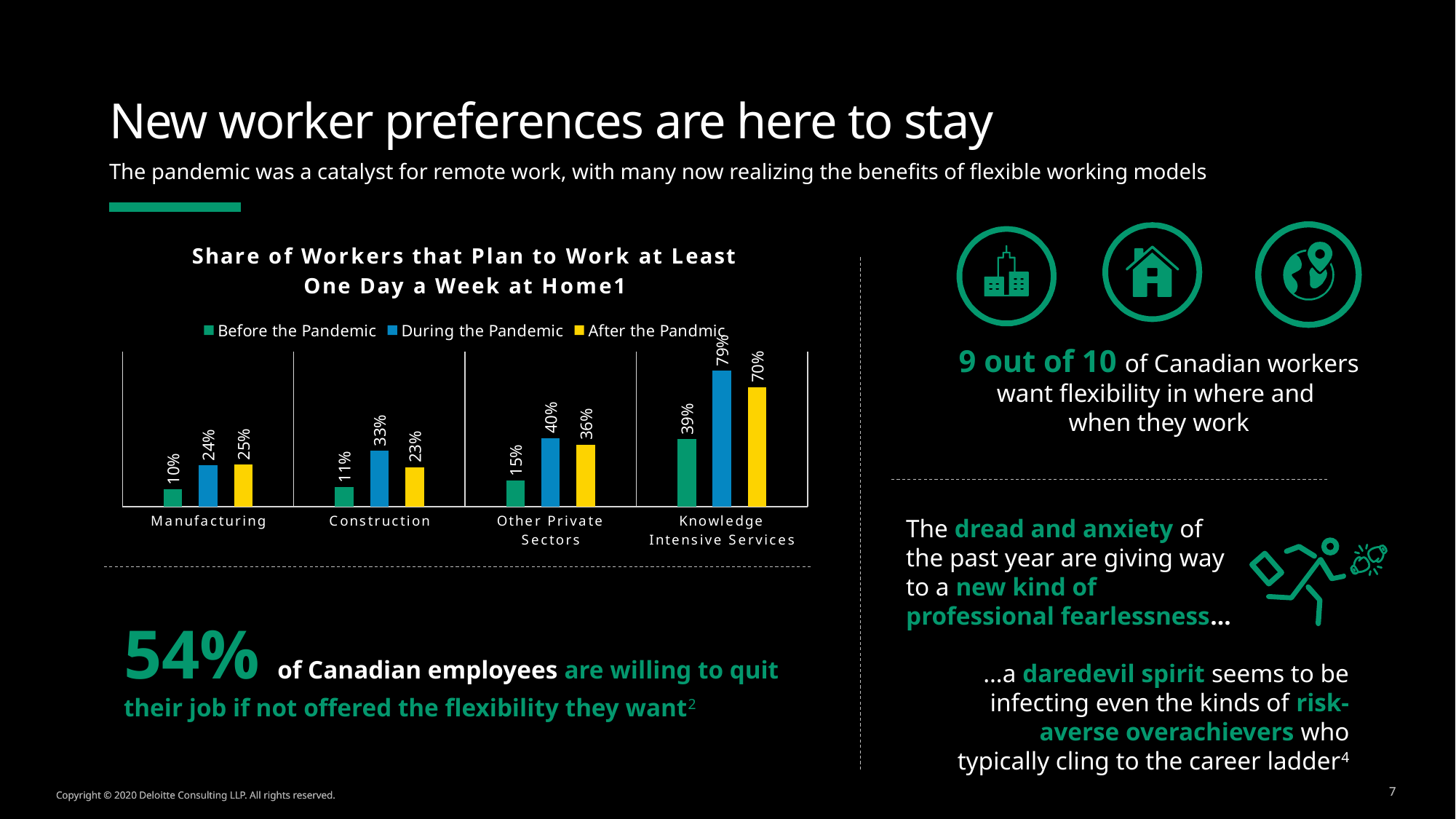
What is the value for Manufacturing in the Before the Pandemic series? 10% For Construction, which is larger: the During the Pandemic value or the After the Pandmic value? During the Pandemic How many categories are shown on the x axis of the chart? 4 What is the value for Construction in the After the Pandmic series? 23% What is the value for Knowledge Intensive Services in the During the Pandemic series? 79% Do the Before the Pandemic values rise or fall from Manufacturing to Knowledge Intensive Services? Rise Which category has the highest value in the During the Pandemic series? Knowledge Intensive Services What is the title of the chart? Share of Workers that Plan to Work at Least One Day a Week at Home1 What kind of chart is shown on the slide? Bar chart How many series does the chart legend list? 3 What is the difference between the During the Pandemic and Before the Pandemic values for Other Private Sectors? 25% Which category has the lowest value in the Before the Pandemic series? Manufacturing